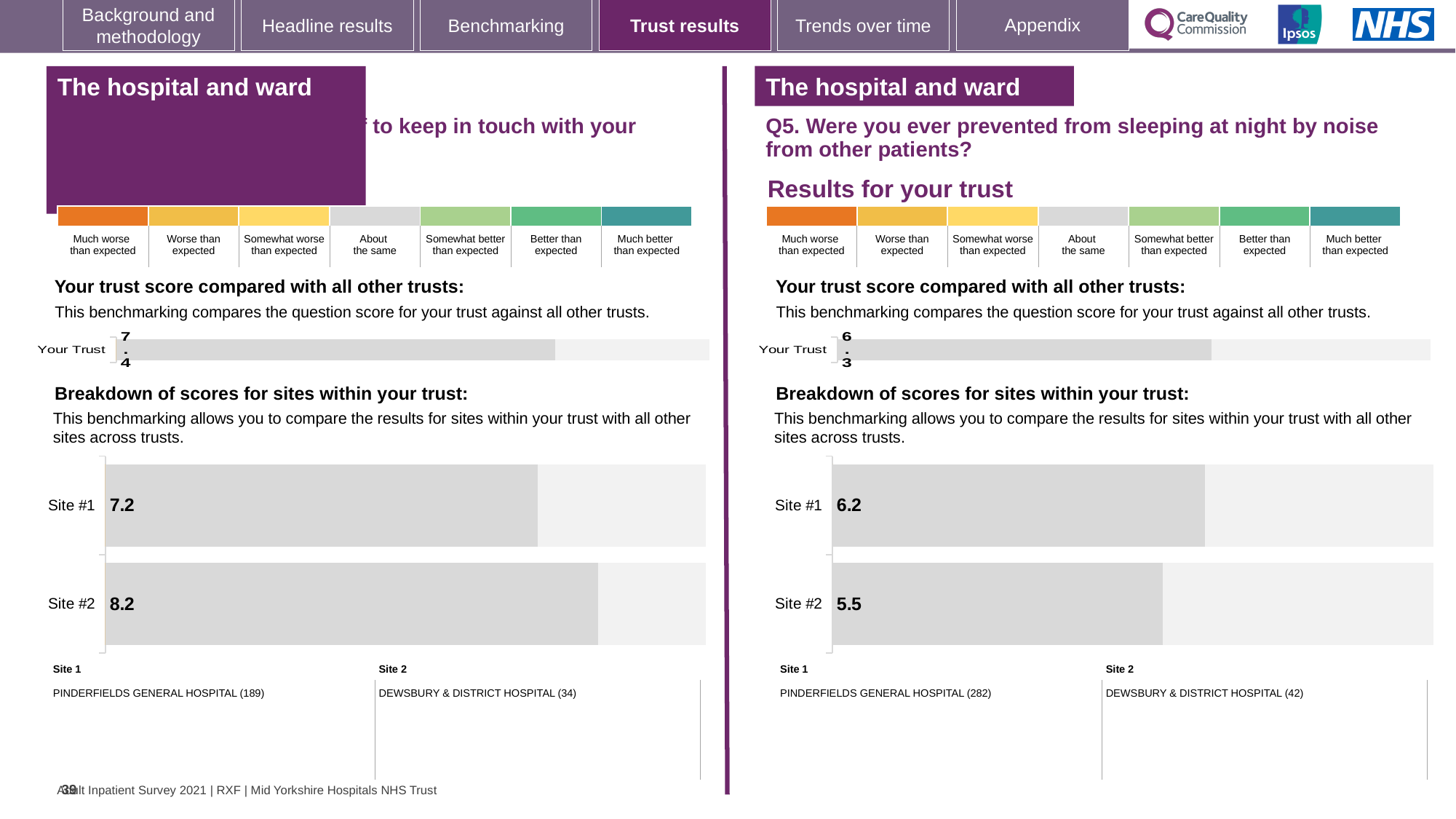
On the left-hand side of the slide, what is the score for Site #1 in the breakdown of scores for sites within your trust? 7.2 What type of chart is used for the breakdown of scores for sites within your trust on the right-hand side of the slide? Bar chart On the left-hand side of the slide, what is the difference between the Site #2 score and the Site #1 score in the site breakdown chart? 1.0 On the right-hand side of the slide (Q5), which site has the higher score in the breakdown of sites within your trust? Site #1 On the right-hand side of the slide (Q5), what is the 'Your Trust' score shown in the trust score comparison bar? 6.3 On the left-hand side of the slide, which site has the lower score in the breakdown of sites within your trust? Site #1 On the left-hand side of the slide, what is the 'Your Trust' score shown in the trust score comparison bar? 7.4 On the right-hand side of the slide (Q5), what is the score for Site #2 in the breakdown of scores for sites within your trust? 5.5 On the left-hand side of the slide, what is the score for Site #2 in the breakdown of scores for sites within your trust? 8.2 On the right-hand side of the slide (Q5, prevented from sleeping by noise from other patients), what is the score for Site #1 in the breakdown of scores for sites within your trust? 6.2 How many sites are shown in the breakdown of scores chart on the right-hand side of the slide (Q5)? 2 On the right-hand side of the slide (Q5), what is the difference between the Site #1 score and the Site #2 score in the site breakdown chart? 0.7